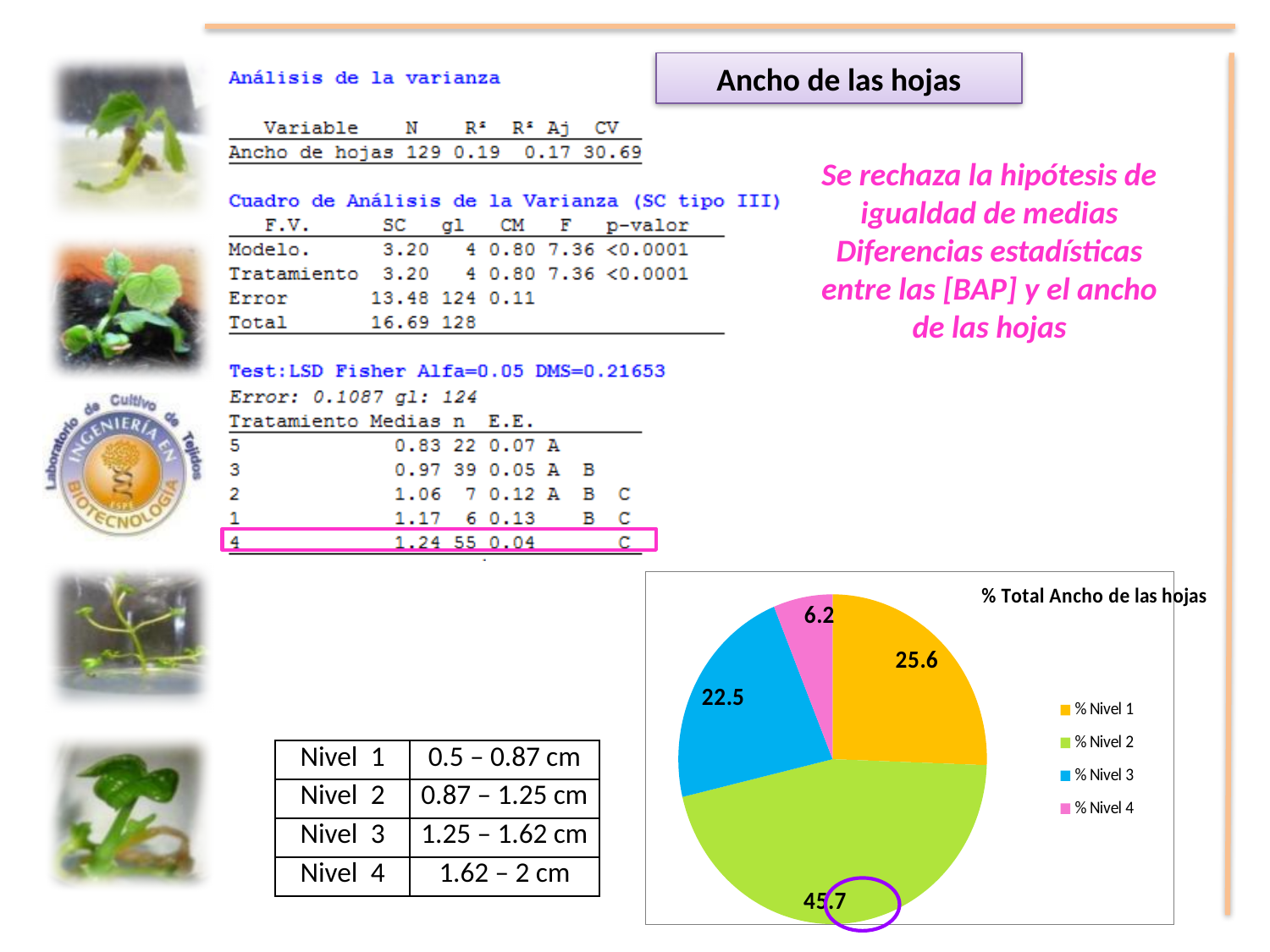
What kind of chart is shown on the slide? pie chart How many entries does the legend of the pie chart list? 4 Which slice of the pie chart is the smallest? % Nivel 4 What is the value shown for % Nivel 1 in the pie chart? 25.6 What is the value shown for % Nivel 4 in the pie chart? 6.2 What is the value shown for % Nivel 3 in the pie chart? 22.5 What is the title of the pie chart? % Total Ancho de las hojas How many slices does the pie chart have? 4 What is the value shown for % Nivel 2 in the pie chart? 45.7 What is the difference between the values for % Nivel 2 and % Nivel 1 in the pie chart? 20.1 Which is larger in the pie chart, % Nivel 1 or % Nivel 3? % Nivel 1 Which slice of the pie chart is the largest? % Nivel 2